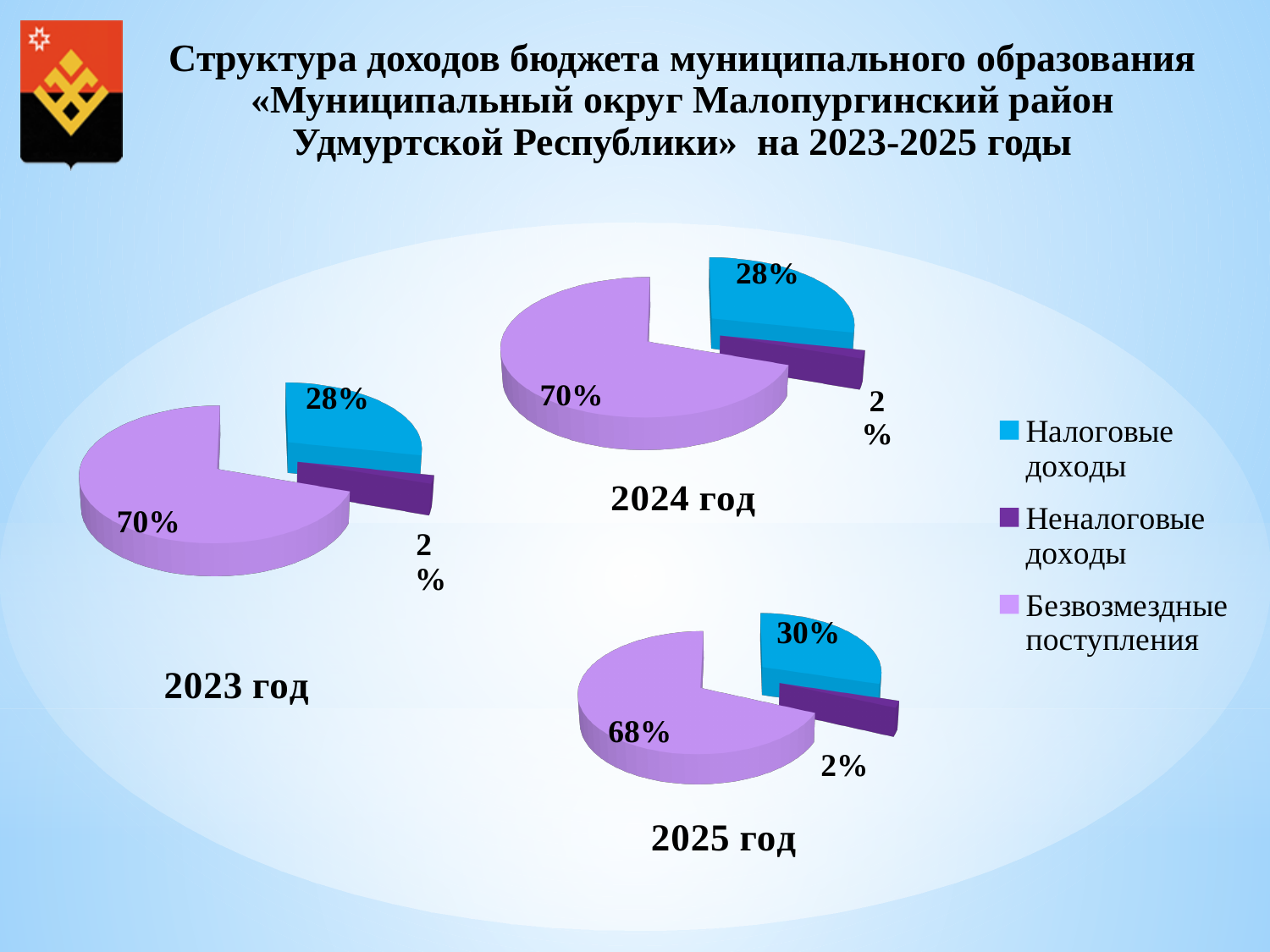
In the 2025 год chart, which category has the largest slice? Безвозмездные поступления What kind of chart is used for the 2023 год chart? Pie chart In the 2025 год chart, what is the difference between the shares of Безвозмездные поступления and Налоговые доходы? 38% In the 2025 год chart, what share is labelled for Безвозмездные поступления? 68% Which is larger: the Налоговые доходы share in the 2025 год chart or in the 2023 год chart? 2025 год In the 2023 год chart, what share is labelled for Безвозмездные поступления? 70% In the 2023 год chart, what share is labelled for Налоговые доходы? 28% In the 2024 год chart, which category has the smallest slice? Неналоговые доходы In the 2025 год chart, what share is labelled for Налоговые доходы? 30% In the 2024 год chart, what share is labelled for Неналоговые доходы? 2% How many categories does the legend list? 3 How many pie charts are shown on the slide? 3